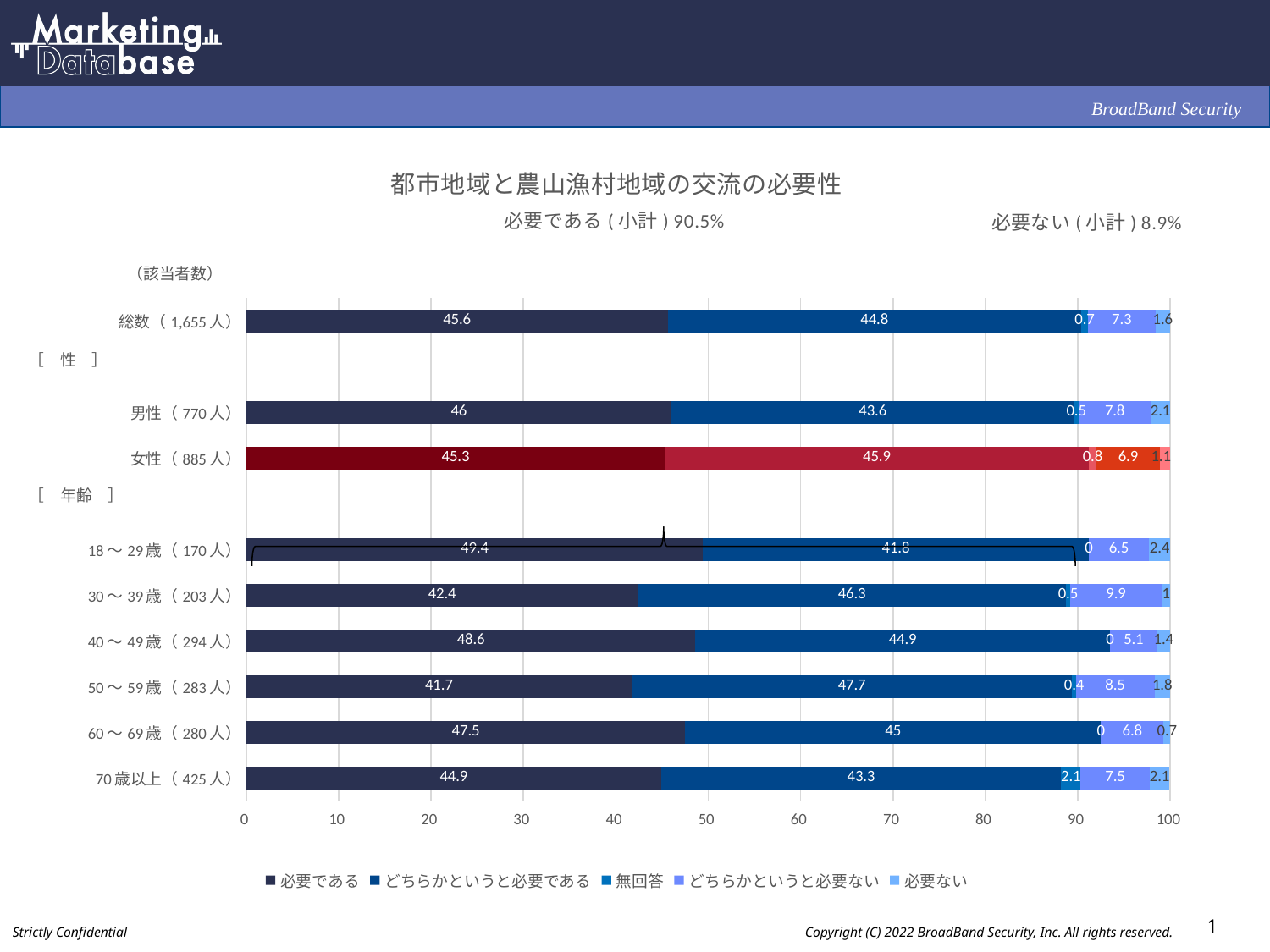
How many series does the legend list? 5 What is the value of どちらかというと必要である for 女性 (885人)? 45.9 What is the value of どちらかというと必要ない for 30～39歳 (203人)? 9.9 Which category has the highest value for 必要である? 18～29歳 (170人) How many categories are shown on the chart? 9 Which category has the lowest value for 必要である? 50～59歳 (283人) Which category has the lowest value for どちらかというと必要ない? 40～49歳 (294人) What is the value of 必要である for 総数 (1,655人)? 45.6 What is the difference between the 必要である values for 男性 (770人) and 女性 (885人)? 0.7 Which has a larger 必要である value, 18～29歳 (170人) or 70歳以上 (425人)? 18～29歳 (170人) What is the value of 無回答 for 70歳以上 (425人)? 2.1 What kind of chart is shown on the slide? Stacked bar chart